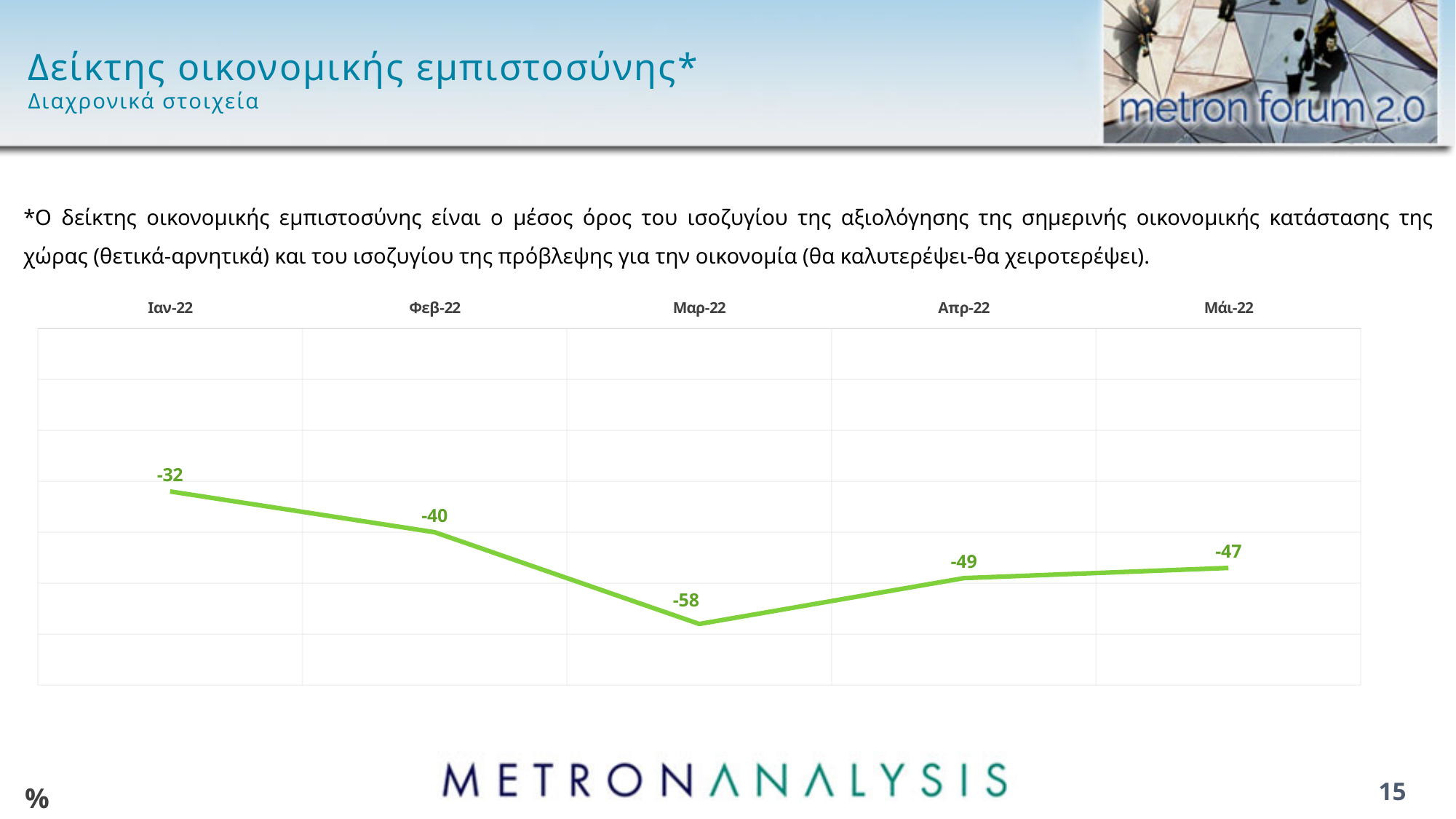
What is the value for Μάι-22? -47 What is the difference between the values for Φεβ-22 and Μαρ-22? 18 Which is larger, the value for Φεβ-22 or the value for Απρ-22? Φεβ-22 What is the difference between the values for Απρ-22 and Μάι-22? 2 What is the value for Ιαν-22? -32 What colour is the line on the chart? green Do the values rise or fall from Ιαν-22 to Μαρ-22? fall How many months are plotted on the chart? 5 What is the value for Μαρ-22? -58 Which month has the highest value? Ιαν-22 What kind of chart is shown on the slide? line chart Which month has the lowest value? Μαρ-22